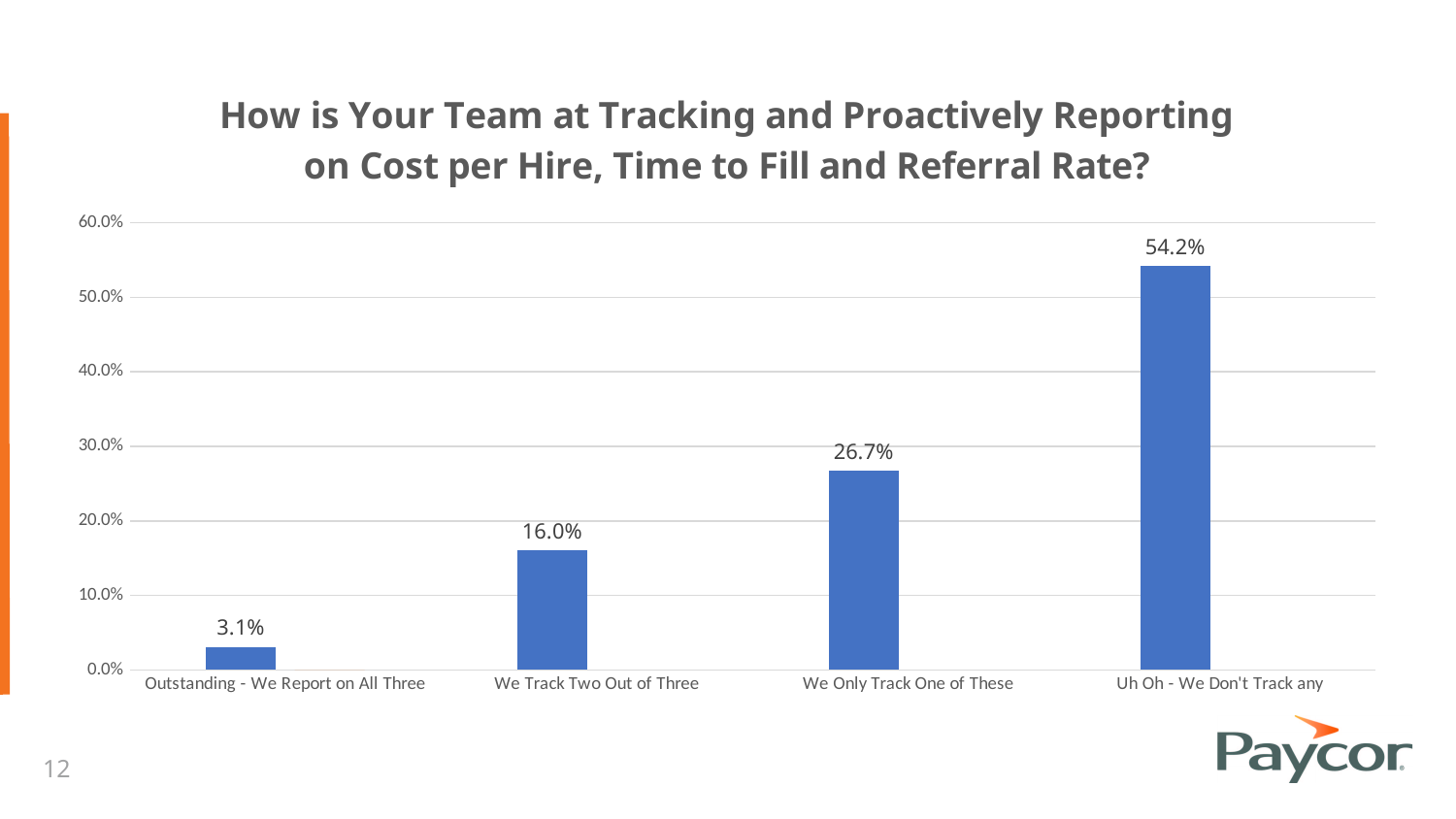
What is the value for "Outstanding - We Report on All Three"? 3.1% Is the value for "Uh Oh - We Don't Track any" greater or less than 50.0%? greater What is the value for "We Track Two Out of Three"? 16.0% What kind of chart is shown on the slide? Bar chart How many categories are shown on the chart? 4 Which category has the lowest value? Outstanding - We Report on All Three Do the values rise or fall from left to right along the x axis? Rise What is the value for "Uh Oh - We Don't Track any"? 54.2% Which category has the highest value? Uh Oh - We Don't Track any What is the difference between the values for "Uh Oh - We Don't Track any" and "We Only Track One of These"? 27.5% What is the value for "We Only Track One of These"? 26.7% Which is larger, the value for "We Track Two Out of Three" or "We Only Track One of These"? We Only Track One of These